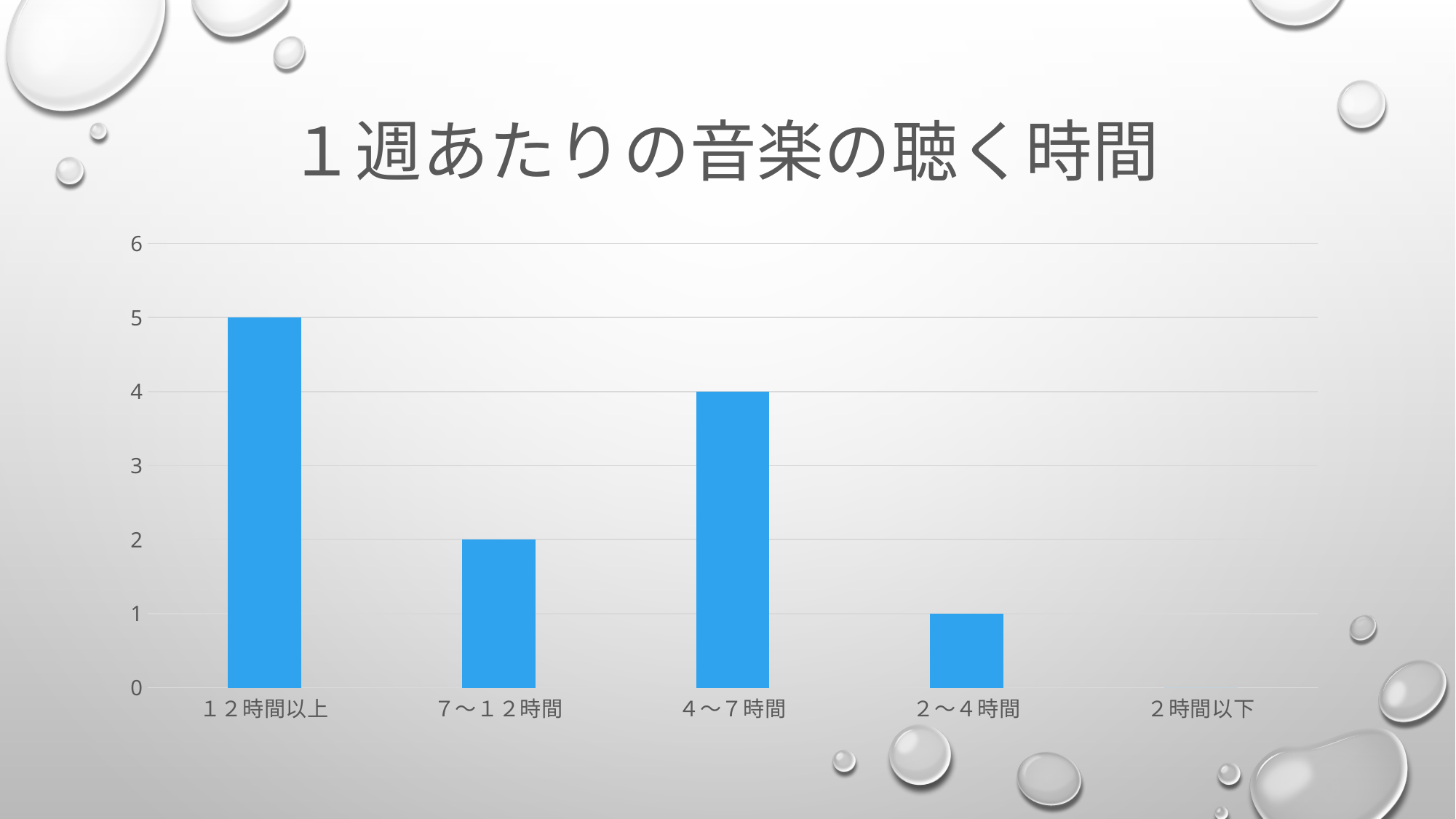
What is the value for １２時間以上? 5 What is the title of the chart? １週あたりの音楽の聴く時間 What is the value for ７～１２時間? 2 Which category has the highest value? １２時間以上 Which is larger, the value for ７～１２時間 or the value for ４～７時間? ４～７時間 Is the value for ４～７時間 greater or less than 3? greater What kind of chart is shown on the slide? bar chart Which category has the lowest value? ２時間以下 What is the value for ４～７時間? 4 What is the difference between the values for １２時間以上 and ４～７時間? 1 How many categories are shown on the x axis? 5 What is the value for ２～４時間? 1